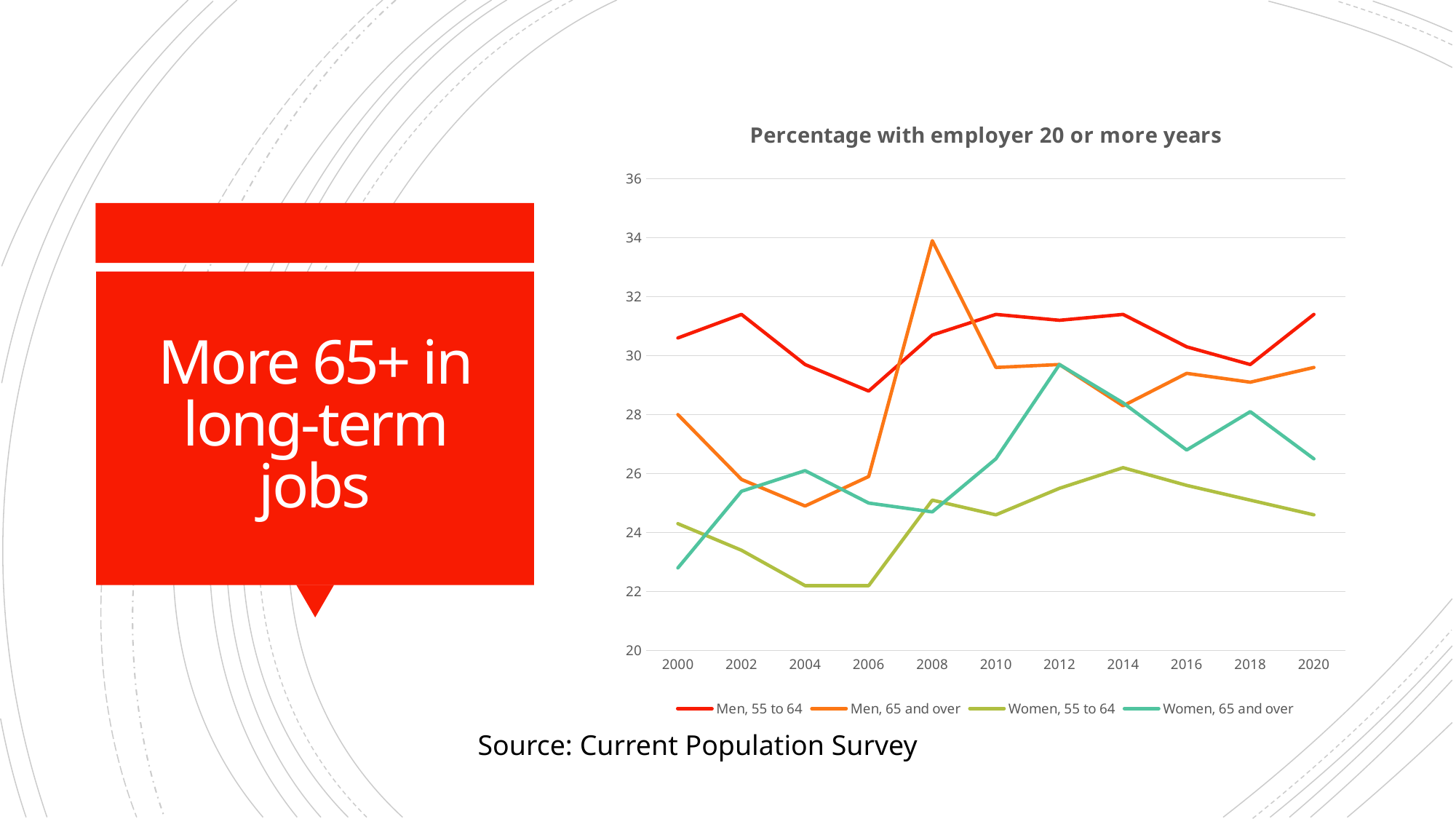
Is the value for Women, 55 to 64 in 2004 greater or less than 24? less How many years are shown along the x axis? 11 In which year does the Men, 65 and over series reach its peak? 2008 What is the title of the chart? Percentage with employer 20 or more years Is the value for Men, 55 to 64 in 2006 greater or less than 30? less In 2020, which is larger: Men, 55 to 64 or Women, 55 to 64? Men, 55 to 64 Which series has the highest value in 2008? Men, 65 and over Which series has the lowest value in 2000? Women, 65 and over Does the Women, 65 and over series rise or fall from 2000 to 2012? rise What kind of chart is shown on the slide? line chart Is the value for Men, 65 and over in 2008 greater or less than 32? greater How many series does the legend list? 4